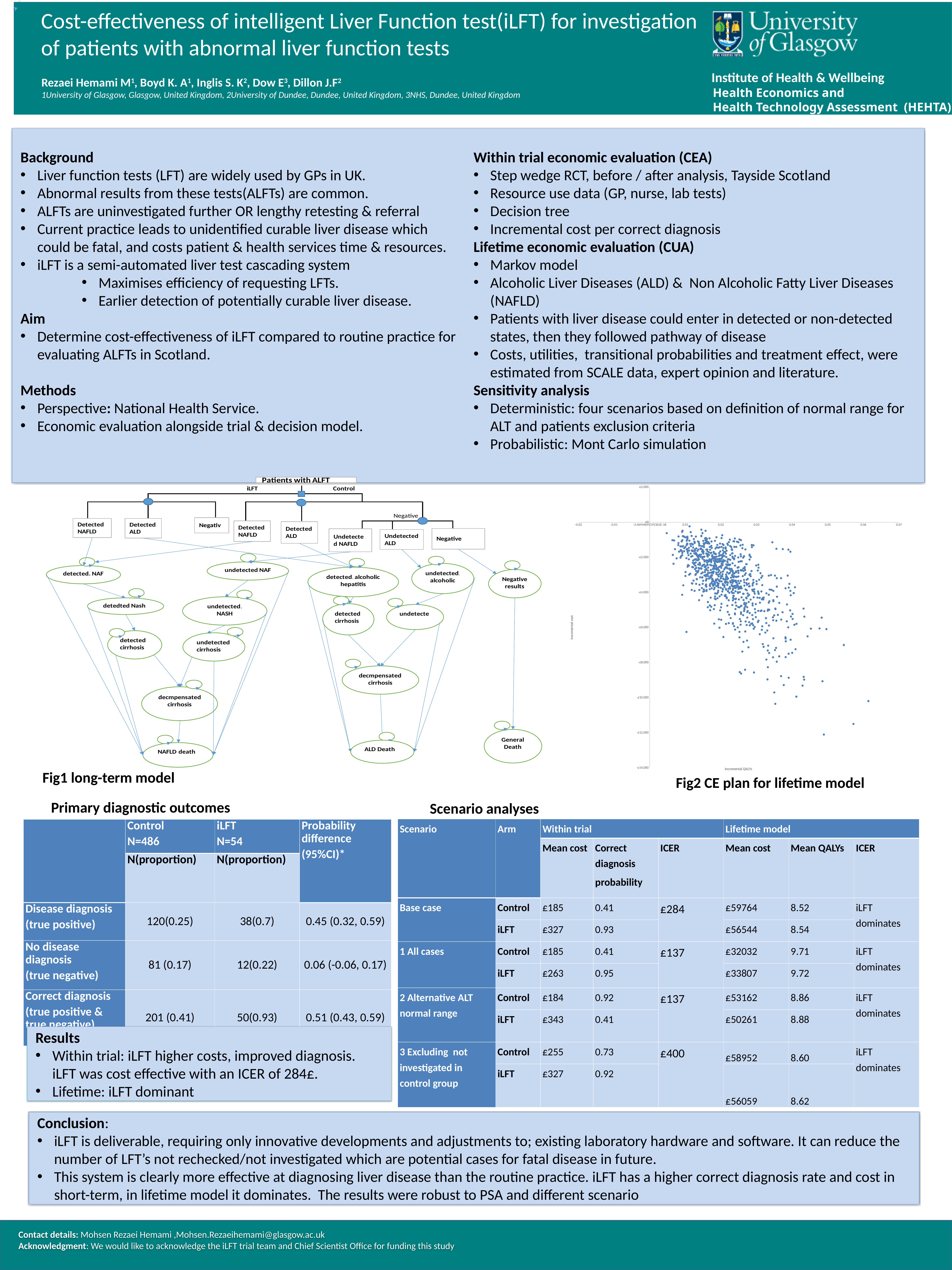
In Fig2 CE plan for lifetime model, does incremental cost rise or fall as incremental QALYs increase along the x axis? fall In Fig2 CE plan for lifetime model, do most of the plotted points have an incremental cost greater or less than £0? less In Fig2 CE plan for lifetime model, do most of the plotted points have incremental QALYs greater or less than 0? greater What kind of chart is Fig2 CE plan for lifetime model? scatter chart What is the title of the scatter chart on the right side of the slide? Fig2 CE plan for lifetime model What does the x axis of Fig2 CE plan for lifetime model represent? Incremental QALYs